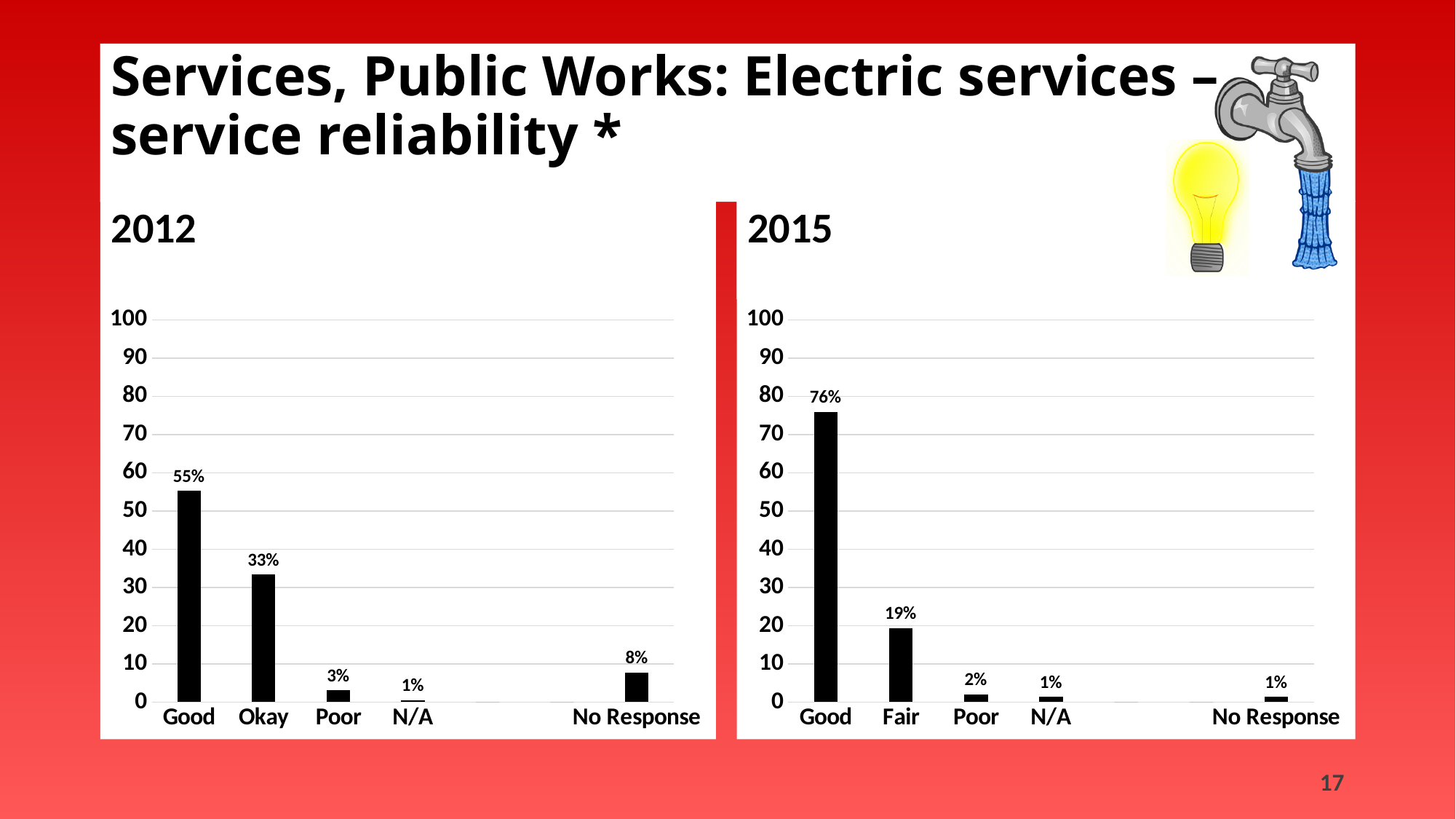
In the 2012 chart, what is the value for No Response? 8% In the 2015 chart, which category has the highest value? Good In the 2015 chart, what is the difference between the values for Good and Fair? 57% What kind of chart is the 2015 chart? Bar chart In the 2012 chart, which category has the highest value? Good In the 2015 chart, what is the value for Poor? 2% In the 2012 chart, what is the difference between the values for Good and Okay? 22% In the 2015 chart, what is the value for Good? 76% In the 2015 chart, what is the value for Fair? 19% Which is larger: the value for Good in the 2012 chart or the value for Good in the 2015 chart? Good in the 2015 chart In the 2012 chart, what is the value for Good? 55% In the 2012 chart, what is the value for Okay? 33%